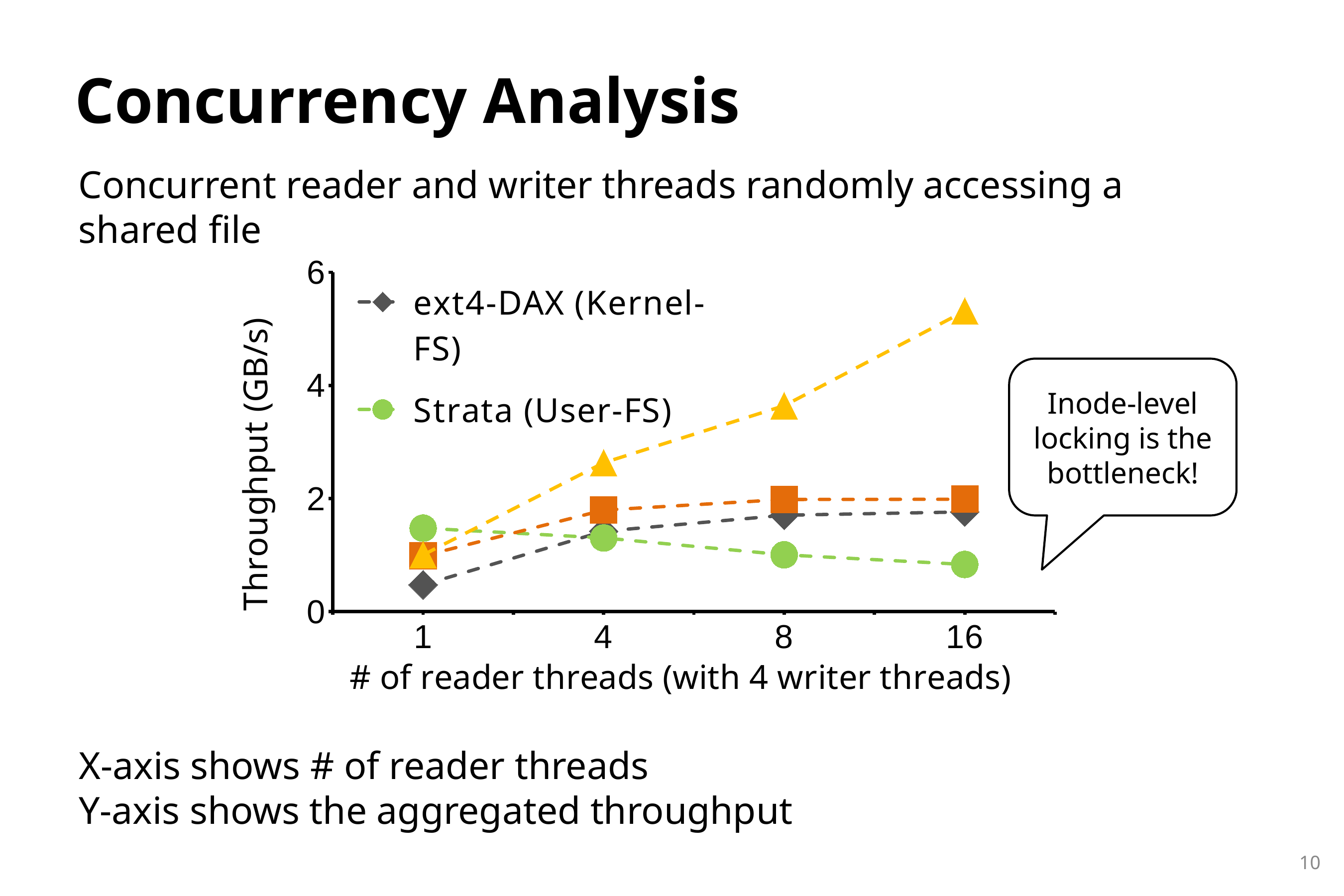
Is the throughput for Strata (User-FS) at 16 reader threads greater or less than 2 GB/s? less What kind of chart is shown on the slide? line chart At 16 reader threads, which has the higher throughput: ext4-DAX (Kernel-FS) or Strata (User-FS)? ext4-DAX (Kernel-FS) Is the throughput for ext4-DAX (Kernel-FS) at 1 reader thread greater or less than 2 GB/s? less Does the throughput for Strata (User-FS) rise or fall as the number of reader threads increases from 1 to 16? fall How many series does the chart's legend list? 2 What is the label of the chart's x axis? # of reader threads (with 4 writer threads) What is the label of the chart's y axis? Throughput (GB/s) Is the throughput for ext4-DAX (Kernel-FS) at 16 reader threads greater or less than 2 GB/s? less How many reader-thread counts are plotted along the x axis? 4 Does the throughput for ext4-DAX (Kernel-FS) rise or fall as the number of reader threads increases from 1 to 16? rise At 1 reader thread, which has the higher throughput: ext4-DAX (Kernel-FS) or Strata (User-FS)? Strata (User-FS)